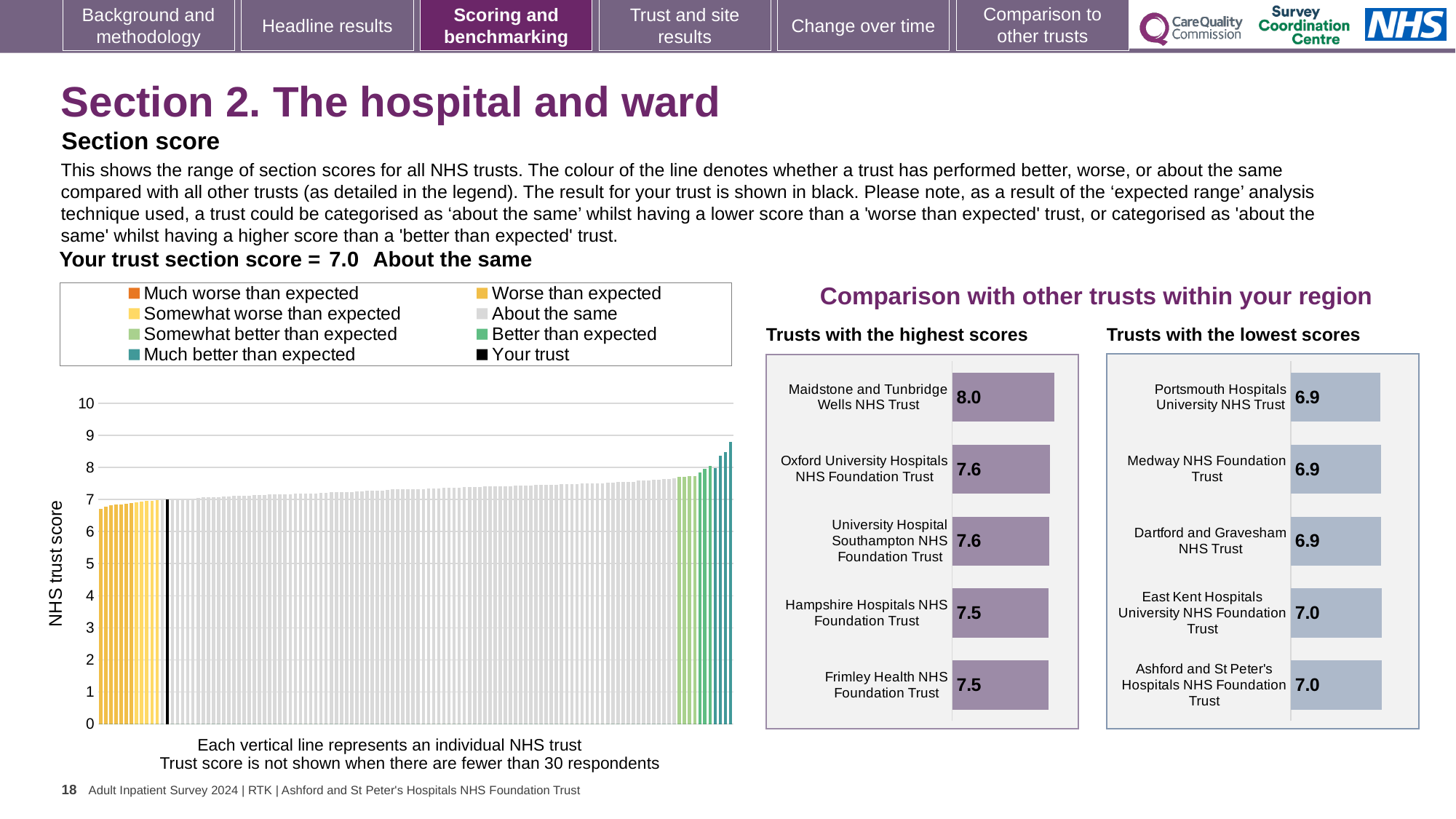
In the 'Trusts with the lowest scores' chart, what is the score for Medway NHS Foundation Trust? 6.9 In the large chart on the left showing NHS trust scores, is the value of the tallest bar greater or less than 8? greater Which is larger: the score for Oxford University Hospitals NHS Foundation Trust in the 'highest scores' chart or the score for Portsmouth Hospitals University NHS Trust in the 'lowest scores' chart? Oxford University Hospitals NHS Foundation Trust How many trusts are shown in the 'Trusts with the lowest scores' chart? 5 In the 'Trusts with the highest scores' chart, what is the difference between the scores of Maidstone and Tunbridge Wells NHS Trust and Frimley Health NHS Foundation Trust? 0.5 In the 'Trusts with the highest scores' chart, what is the score for Maidstone and Tunbridge Wells NHS Trust? 8.0 In the large chart on the left showing NHS trust scores, do the values rise or fall from left to right? rise In the 'Trusts with the lowest scores' chart, what is the score for Ashford and St Peter's Hospitals NHS Foundation Trust? 7.0 In the 'Trusts with the highest scores' chart, which trust has the highest score? Maidstone and Tunbridge Wells NHS Trust In the 'Trusts with the highest scores' chart, what is the score for Hampshire Hospitals NHS Foundation Trust? 7.5 How many entries does the legend of the large chart on the left list? 8 What kind of chart is the large chart on the left showing NHS trust scores? bar chart